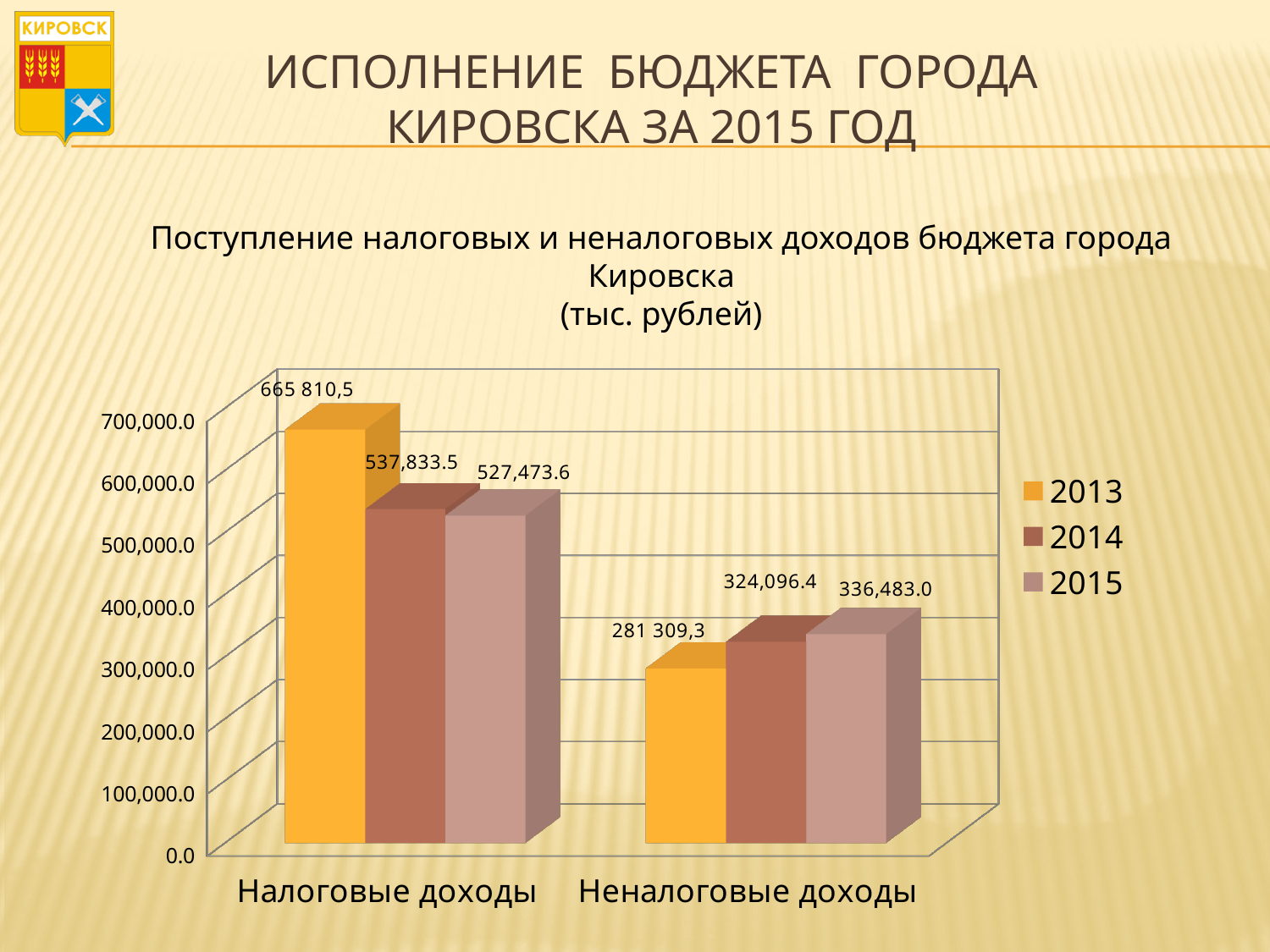
Which is larger for Неналоговые доходы: the 2014 value or the 2015 value? 2015 How many series does the legend list? 3 What is the value for Налоговые доходы in 2013? 665 810,5 What is the difference between the 2015 and 2014 values for Неналоговые доходы? 12,386.6 Which year has the highest value for Налоговые доходы? 2013 What is the difference between the 2014 and 2015 values for Налоговые доходы? 10,359.9 What type of chart is shown on the slide? Bar chart How many categories are shown on the x axis? 2 Which year has the lowest value for Неналоговые доходы? 2013 What is the value for Неналоговые доходы in 2013? 281 309,3 What is the value for Налоговые доходы in 2015? 527,473.6 What is the value for Неналоговые доходы in 2014? 324,096.4